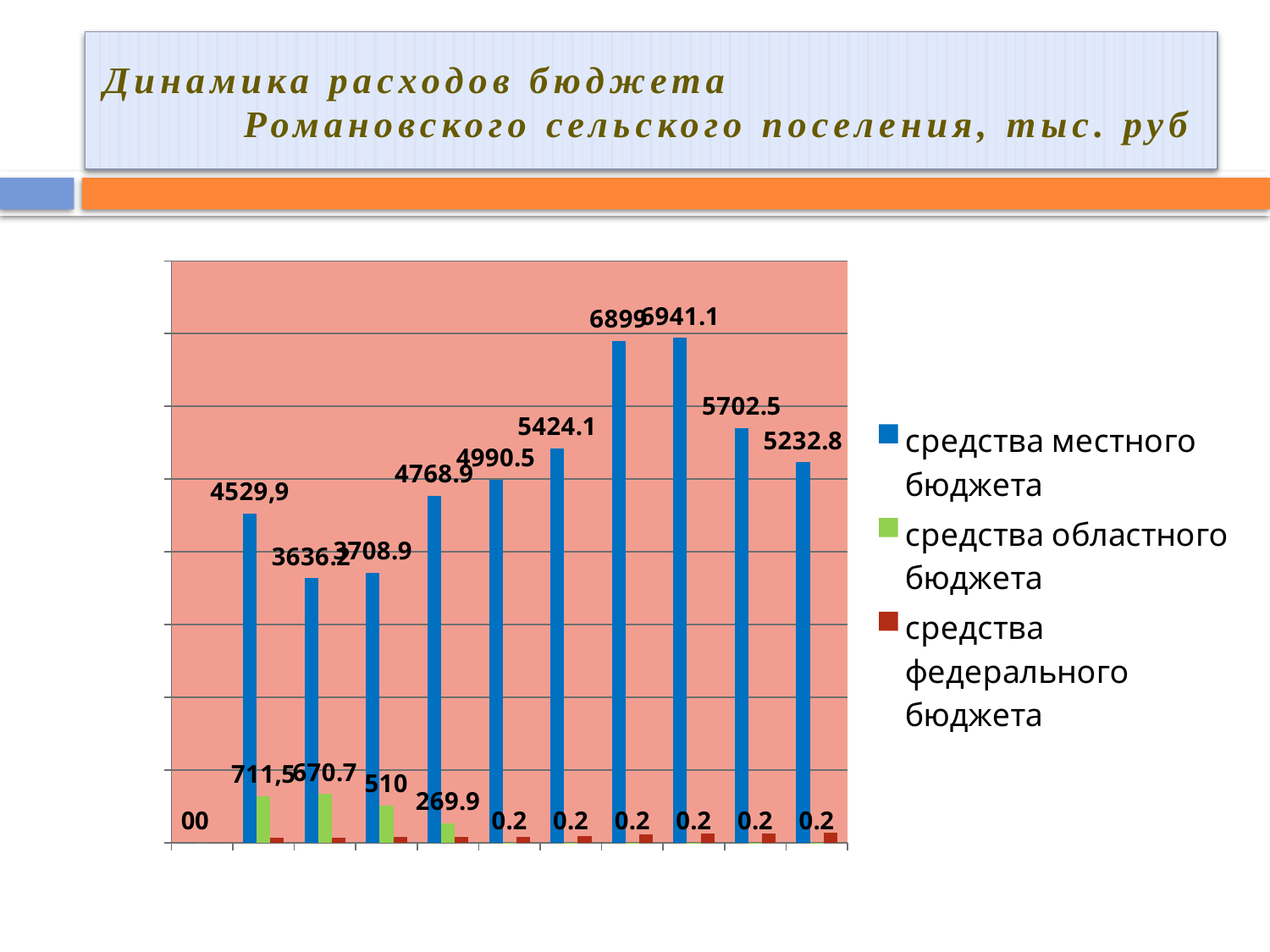
Which colour represents 'средства федерального бюджета' in the legend? dark red What is the title of the chart on the slide? Динамика расходов бюджета Романовского сельского поселения, тыс. руб How many bars of 'средства областного бюджета' are labelled 0.2? 6 What is the lowest labelled value for 'средства местного бюджета'? 3636.2 How many series does the legend list? 3 What is the difference between the labelled values 4990.5 and 4768.9 for 'средства местного бюджета'? 221.6 What kind of chart is shown on the slide? bar chart What is the highest labelled value for 'средства областного бюджета'? 711,5 What is the highest labelled value for 'средства местного бюджета'? 6941.1 Do the values for 'средства местного бюджета' rise or fall from the bar labelled 3708.9 to the bar labelled 6941.1? rise What is the difference between the last two labelled values for 'средства местного бюджета', 5702.5 and 5232.8? 469.7 Which is larger for 'средства местного бюджета': the bar labelled 5424.1 or the bar labelled 4990.5? 5424.1